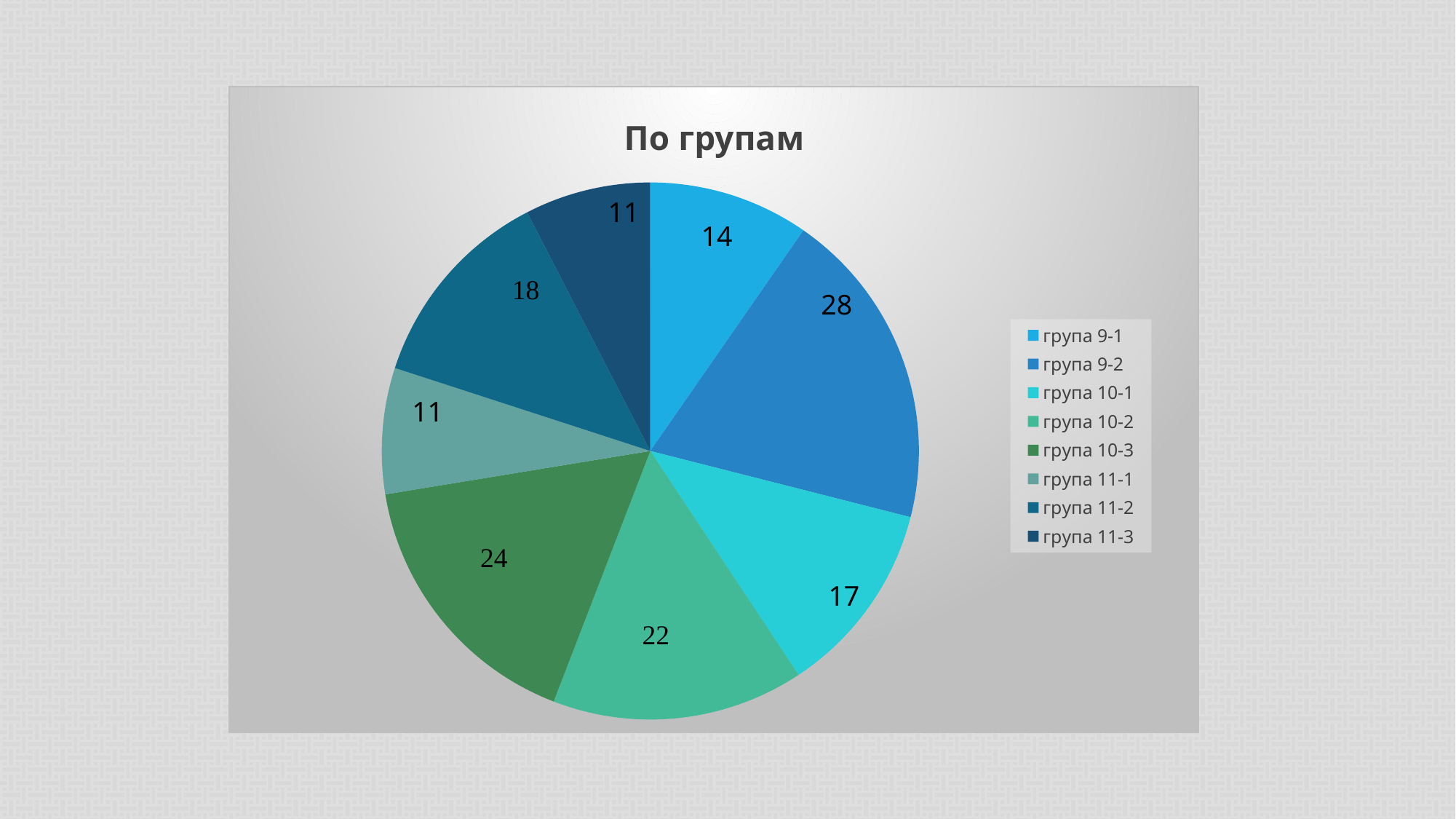
Which group has the largest slice of the pie? група 9-2 What is the value for група 10-1? 17 What is the title of the chart? По групам What is the value for група 11-2? 18 What is the total of all the slice values in the pie chart? 145 What is the value for група 9-2? 28 Which two groups share the smallest value in the pie? група 11-1 and група 11-3 Which is larger, the value for група 10-2 or the value for група 11-2? група 10-2 What is the difference between the values for група 9-2 and група 9-1? 14 What is the value for група 10-3? 24 How many slices does the pie chart have? 8 What type of chart is shown on the slide? pie chart